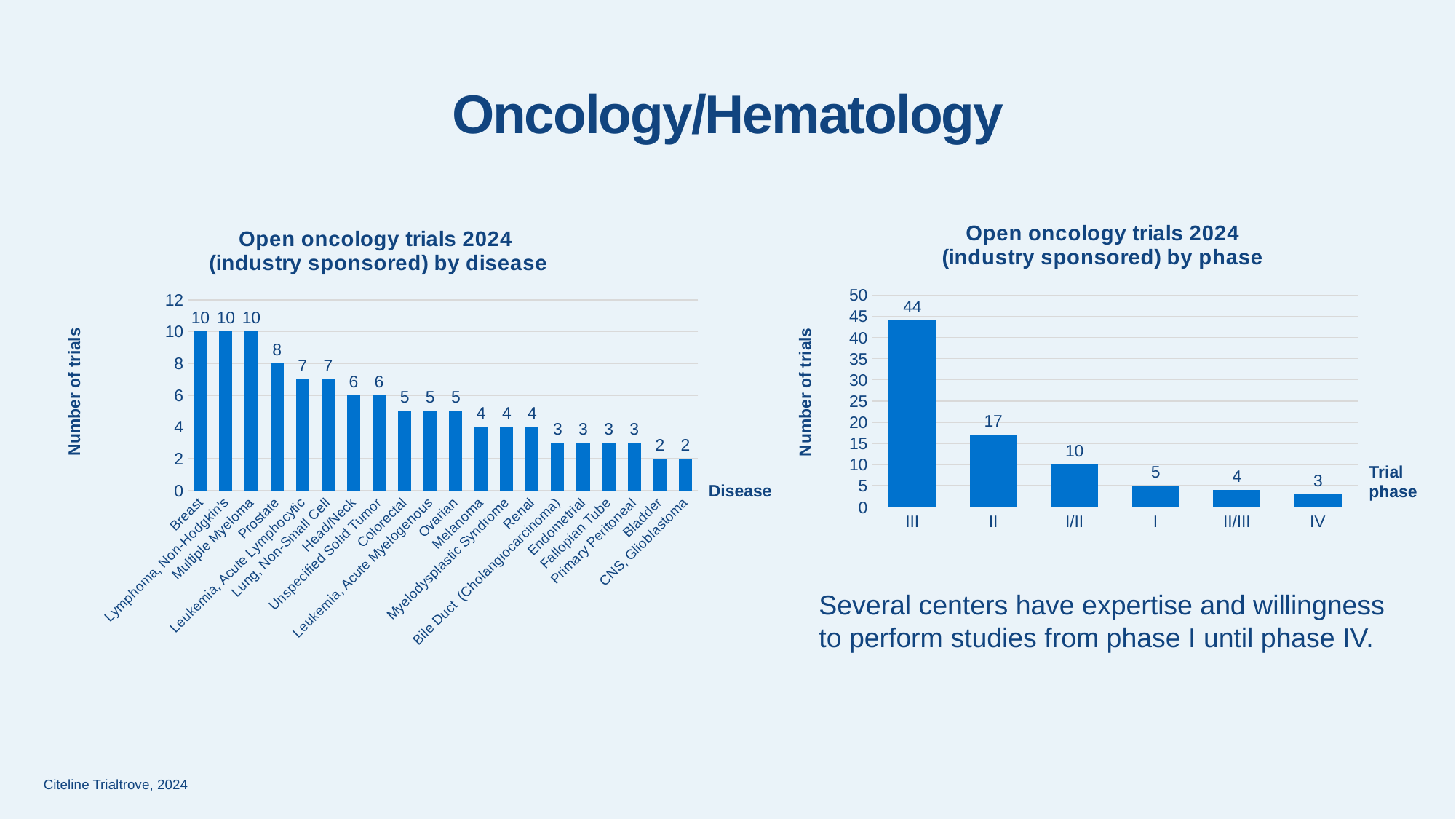
In the 'Open oncology trials 2024 (industry sponsored) by disease' chart, how many trials are there for Melanoma? 4 In the 'Open oncology trials 2024 (industry sponsored) by phase' chart, how many trial phases are shown on the x axis? 6 What type of chart is the 'Open oncology trials 2024 (industry sponsored) by phase' chart? Bar chart In the 'Open oncology trials 2024 (industry sponsored) by disease' chart, how many disease categories are shown? 20 In the 'Open oncology trials 2024 (industry sponsored) by phase' chart, what is the difference between the number of phase III trials and phase II trials? 27 In the 'Open oncology trials 2024 (industry sponsored) by disease' chart, which disease has more trials, Colorectal or Bladder? Colorectal In the 'Open oncology trials 2024 (industry sponsored) by disease' chart, what is the difference between the number of trials for Breast and for Head/Neck? 4 In the 'Open oncology trials 2024 (industry sponsored) by disease' chart, how many trials are there for Prostate? 8 In the 'Open oncology trials 2024 (industry sponsored) by phase' chart, how many trials are in phase I/II? 10 In the 'Open oncology trials 2024 (industry sponsored) by phase' chart, which trial phase has the fewest trials? IV What is the y-axis label of the 'Open oncology trials 2024 (industry sponsored) by disease' chart? Number of trials In the 'Open oncology trials 2024 (industry sponsored) by phase' chart, how many trials are in phase III? 44